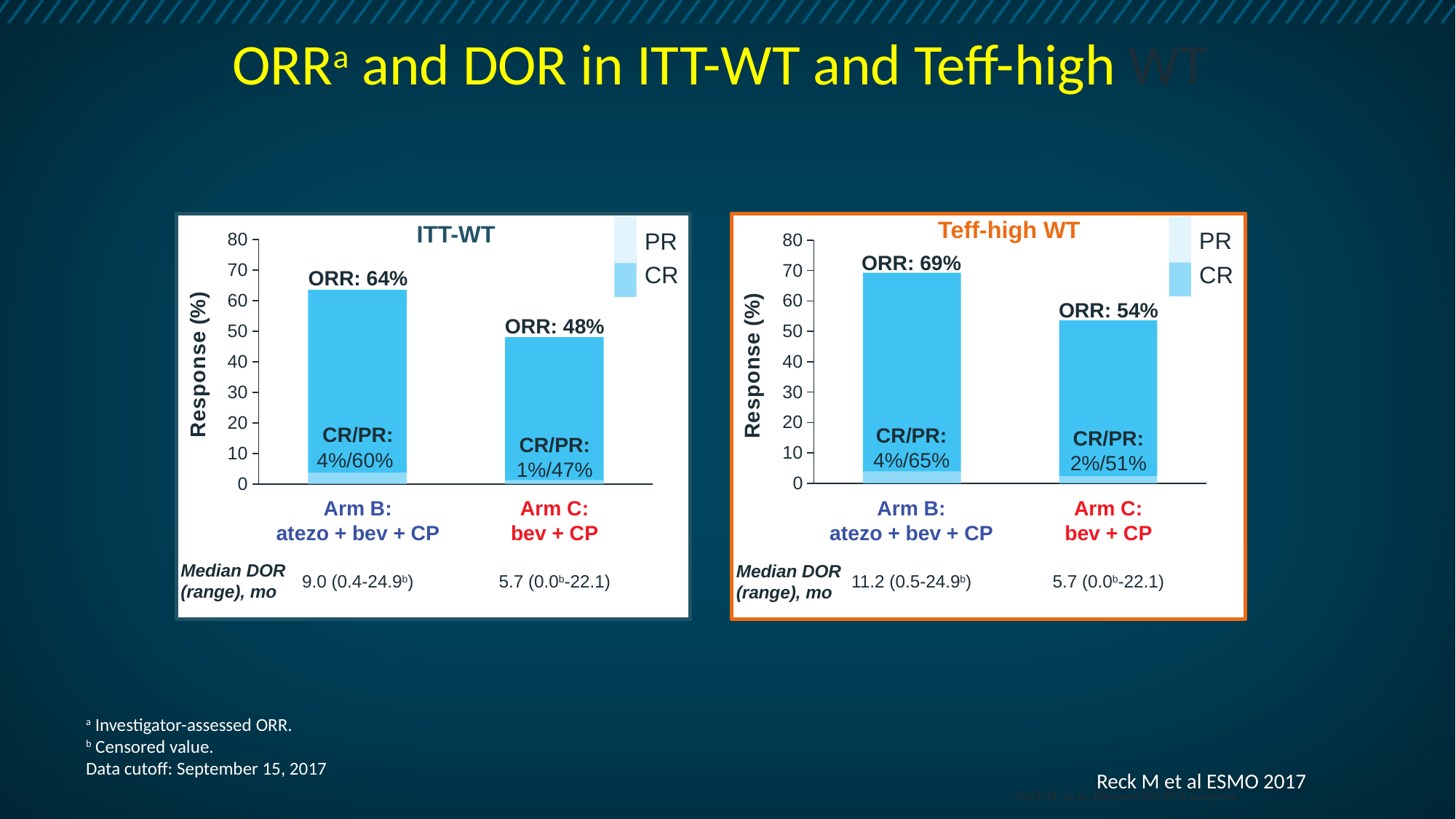
What type of chart is the Teff-high WT chart? Stacked bar chart How many series does the legend list in the ITT-WT chart? 2 In the Teff-high WT chart, what is the ORR for Arm C: bev + CP? 54% In the Teff-high WT chart, what is the CR/PR breakdown for Arm C? 2%/51% In the ITT-WT chart, what is the difference in ORR between Arm B and Arm C? 16% In the Teff-high WT chart, what is the ORR for Arm B: atezo + bev + CP? 69% In the ITT-WT chart, which arm has the higher ORR? Arm B: atezo + bev + CP In the ITT-WT chart, what is the ORR for Arm B: atezo + bev + CP? 64% In the Teff-high WT chart, what is the median DOR for Arm B: atezo + bev + CP? 11.2 (0.5-24.9) mo In the ITT-WT chart, what is the ORR for Arm C: bev + CP? 48% In the ITT-WT chart, what is the CR/PR breakdown for Arm B? 4%/60% In the Teff-high WT chart, what is the difference in ORR between Arm B and Arm C? 15%